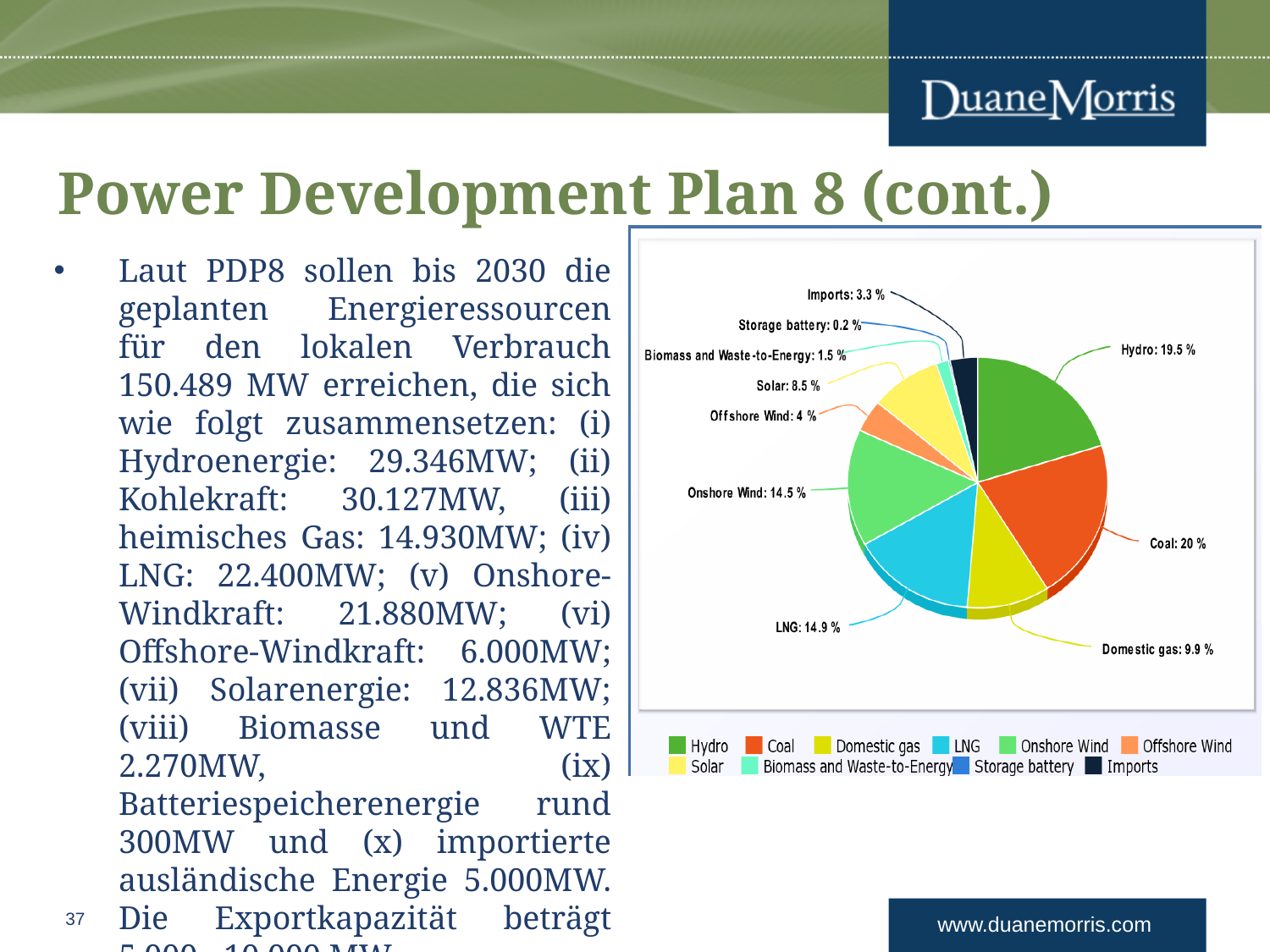
Which category has the smallest share of the pie? Storage battery Which is larger, the share for Solar or the share for Domestic gas? Domestic gas What share of the pie does Hydro represent? 19.5 % How many entries does the legend list? 10 What is the value shown for LNG? 14.9 % What is the value shown for Storage battery? 0.2 % Which category has the largest share of the pie? Coal What share of the pie does Coal represent? 20 % What is the difference between the shares of Onshore Wind and Offshore Wind? 10.5 % What is the value shown for Biomass and Waste-to-Energy? 1.5 % How many categories are shown in the pie chart? 10 What type of chart is shown on the slide? Pie chart